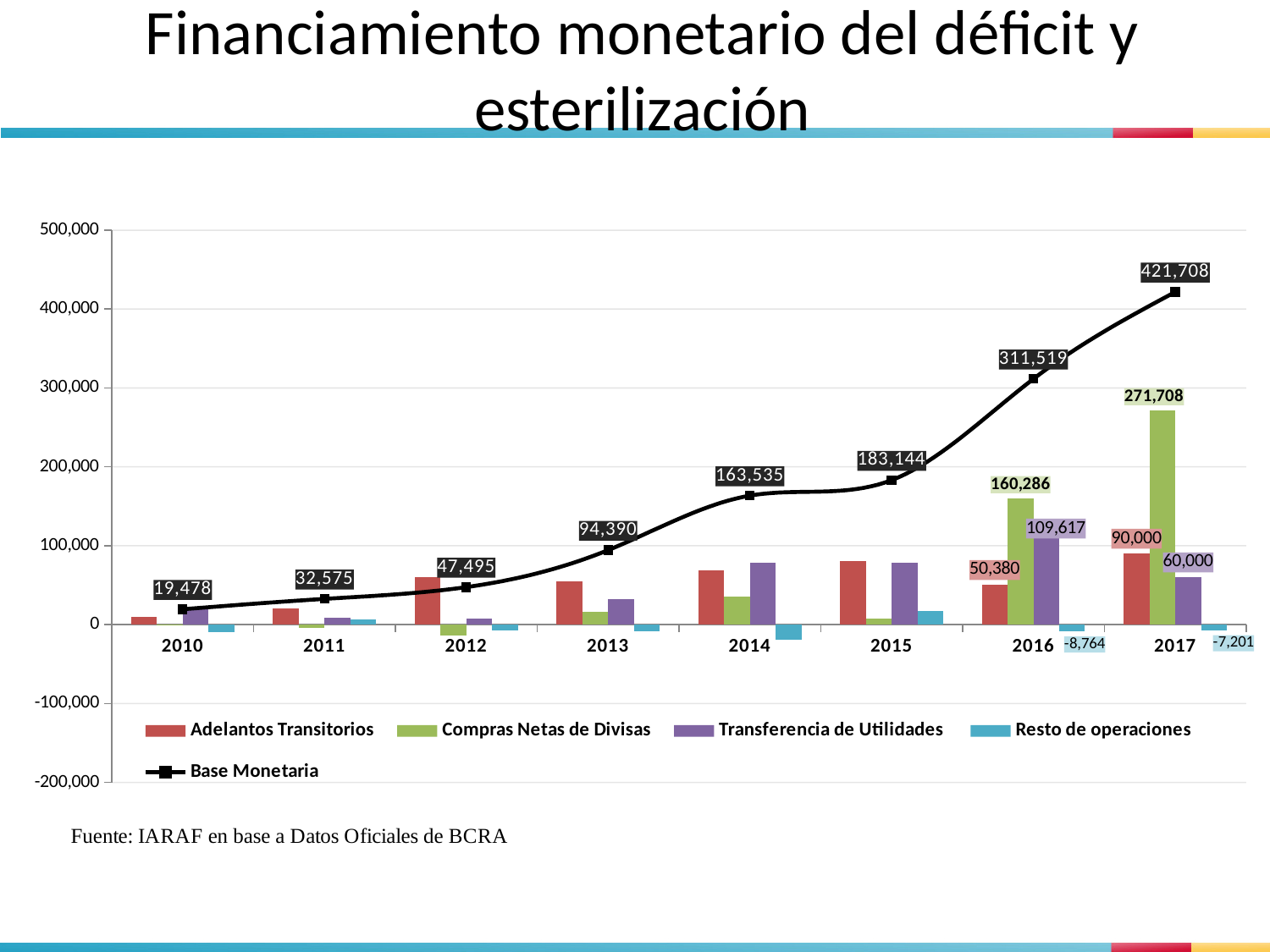
What is the value of Resto de operaciones in 2017? -7,201 What is the value of Base Monetaria in 2010? 19,478 How many years are shown on the x axis? 8 How many series does the legend list? 5 What is the value of Base Monetaria in 2017? 421,708 Is the value of Adelantos Transitorios in 2015 greater or less than 100,000? less Which is larger in 2017: Adelantos Transitorios or Transferencia de Utilidades? Adelantos Transitorios In which year is Base Monetaria highest? 2017 What is the difference between Base Monetaria in 2017 and in 2016? 110,189 In which year is Base Monetaria lowest? 2010 What is the value of Compras Netas de Divisas in 2016? 160,286 What is the value of Transferencia de Utilidades in 2016? 109,617